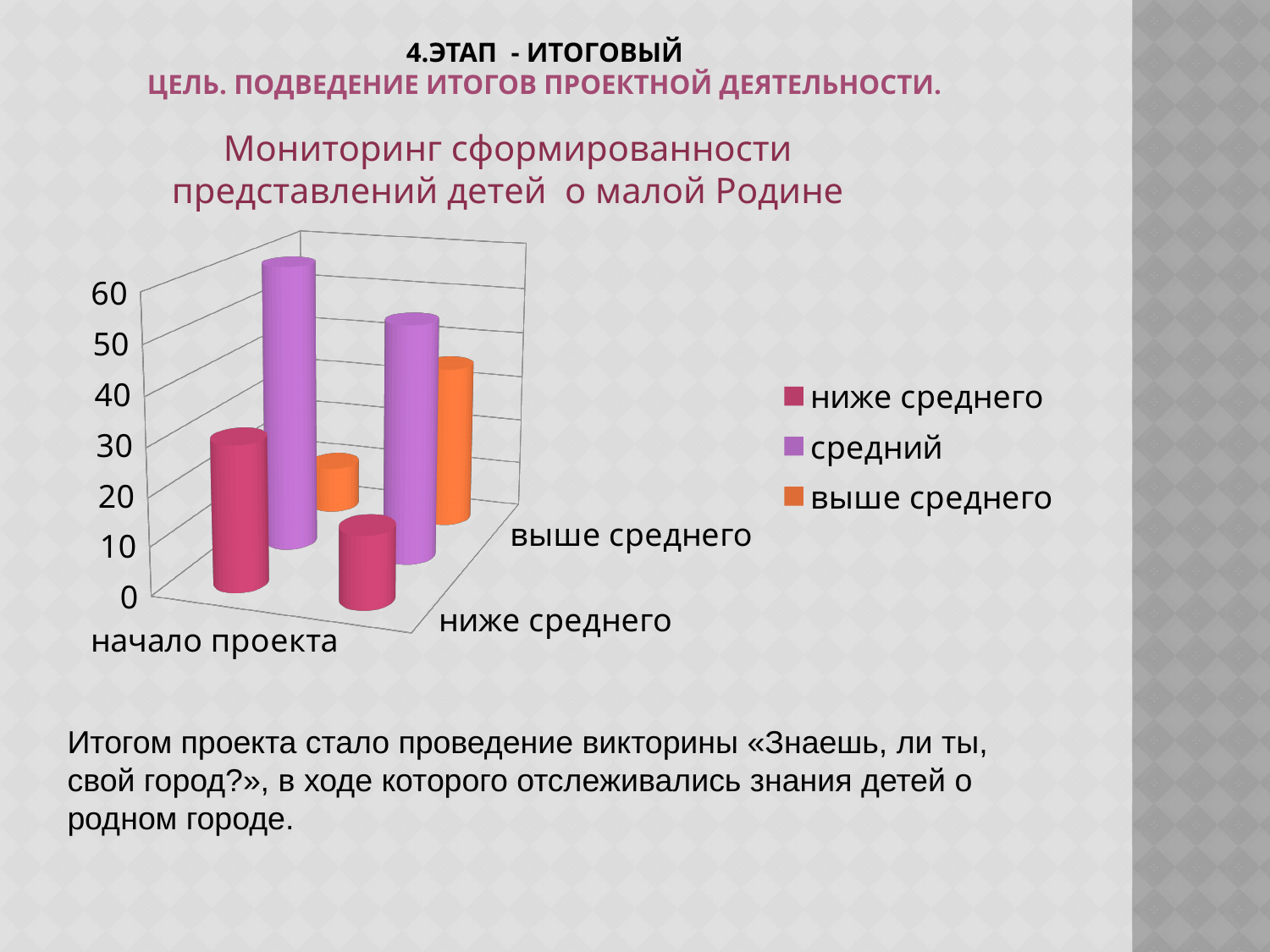
What is the title of the chart? Мониторинг сформированности представлений детей о малой Родине What kind of chart is shown on the slide? bar chart What is the highest value shown on the vertical axis? 60 Which series is shown in orange in the legend? выше среднего Is the value for "средний" at "начало проекта" greater or less than 40? greater How many series does the legend list? 3 Is the value for "ниже среднего" at "начало проекта" greater or less than 50? less Which series has the lowest bar at "начало проекта"? выше среднего Which series has the highest bar at "начало проекта"? средний How many categories are plotted along the x axis? 2 At "начало проекта", which is larger: "ниже среднего" or "выше среднего"? ниже среднего At "начало проекта", which is larger: "средний" or "ниже среднего"? средний